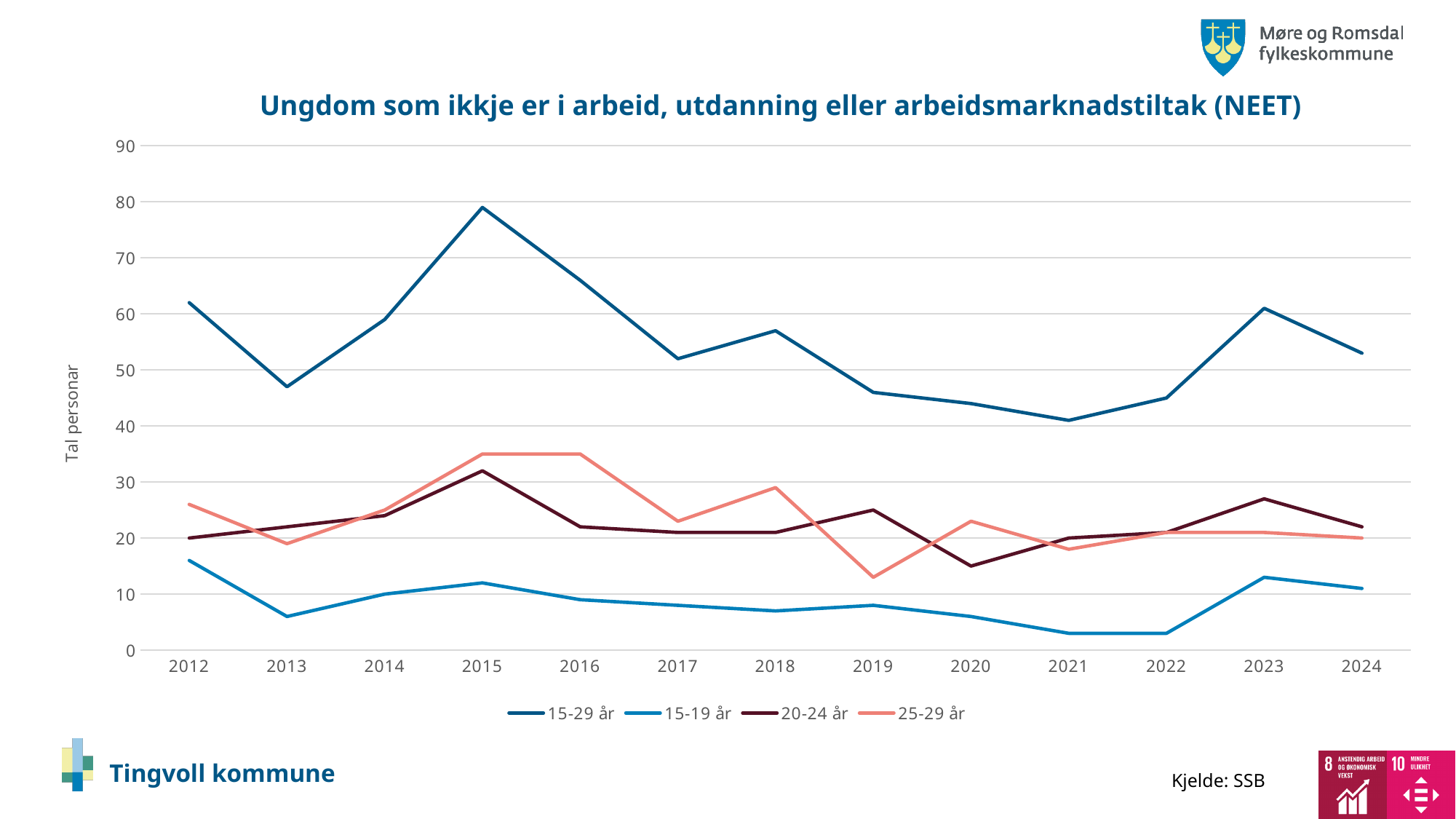
What is the label on the y axis? Tal personar In which year is the value for 15-29 år highest? 2015 In which year is the value for 15-29 år lowest? 2021 In 2016, which series has the higher value: 25-29 år or 20-24 år? 25-29 år What kind of chart is shown on the slide? line chart How many years are shown on the x axis? 13 In 2019, which series has the higher value: 20-24 år or 25-29 år? 20-24 år Is the value for 15-29 år in 2013 greater or less than 50? less Is the value for 15-29 år in 2015 greater or less than 70? greater Does the value for 15-29 år rise or fall from 2018 to 2021? fall How many series does the legend list? 4 Is the value for 15-19 år in 2013 greater or less than 10? less